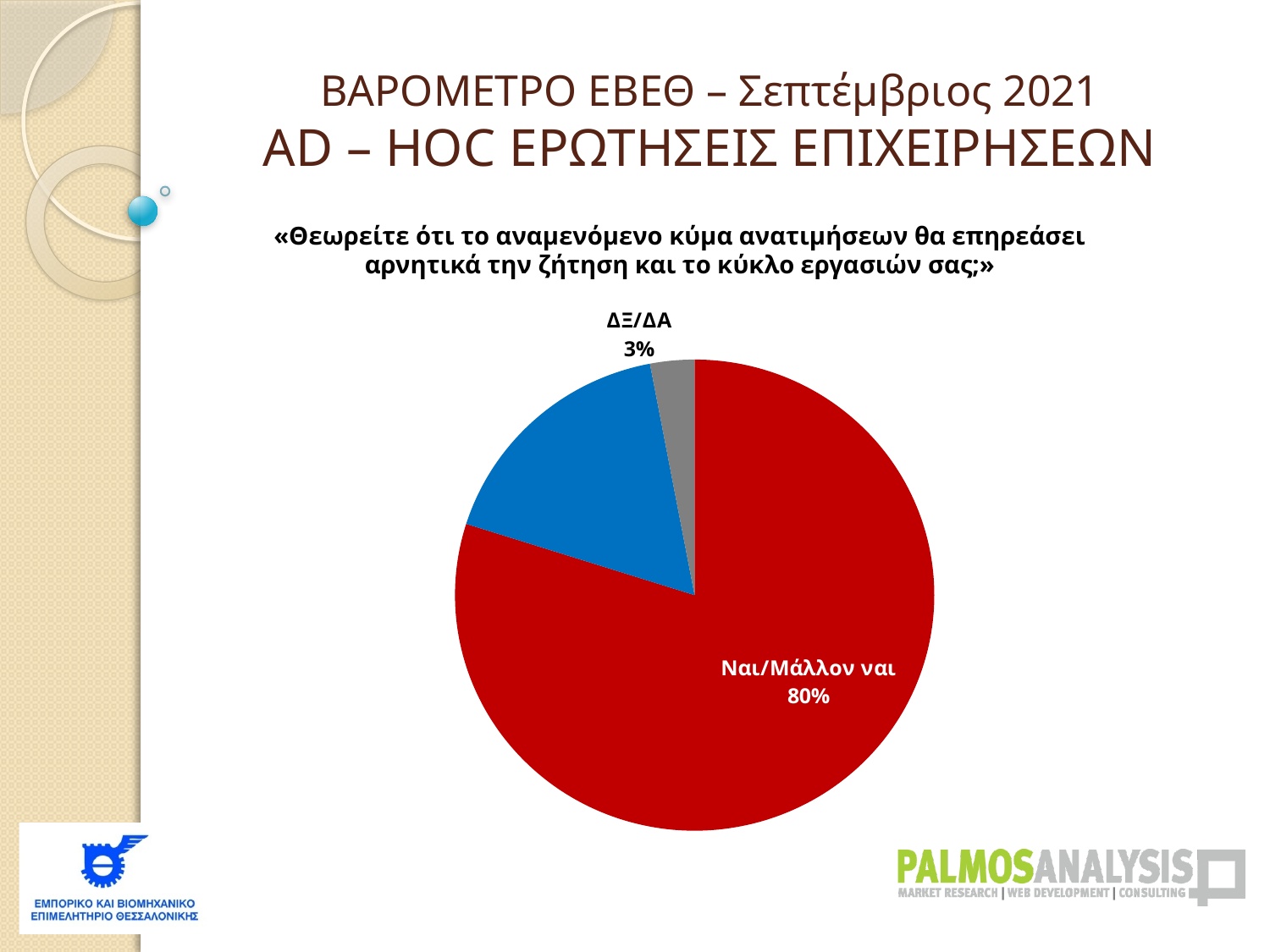
Which slice of the pie is the smallest? ΔΞ/ΔΑ What share of the pie does the "Ναι/Μάλλον ναι" slice represent? 80% How many slices does the pie chart have? 3 By how many percentage points does the "Ναι/Μάλλον ναι" share exceed the "ΔΞ/ΔΑ" share? 77 percentage points What percentage of the pie is labelled "Ναι/Μάλλον ναι"? 80% What kind of chart is shown on the slide? pie chart What colour is the "ΔΞ/ΔΑ" slice of the pie? grey Which labelled slice of the pie is the largest? Ναι/Μάλλον ναι What percentage of the pie is labelled "ΔΞ/ΔΑ"? 3% What colour is the "Ναι/Μάλλον ναι" slice of the pie? red Which is larger: the share for "Ναι/Μάλλον ναι" or the share for "ΔΞ/ΔΑ"? Ναι/Μάλλον ναι